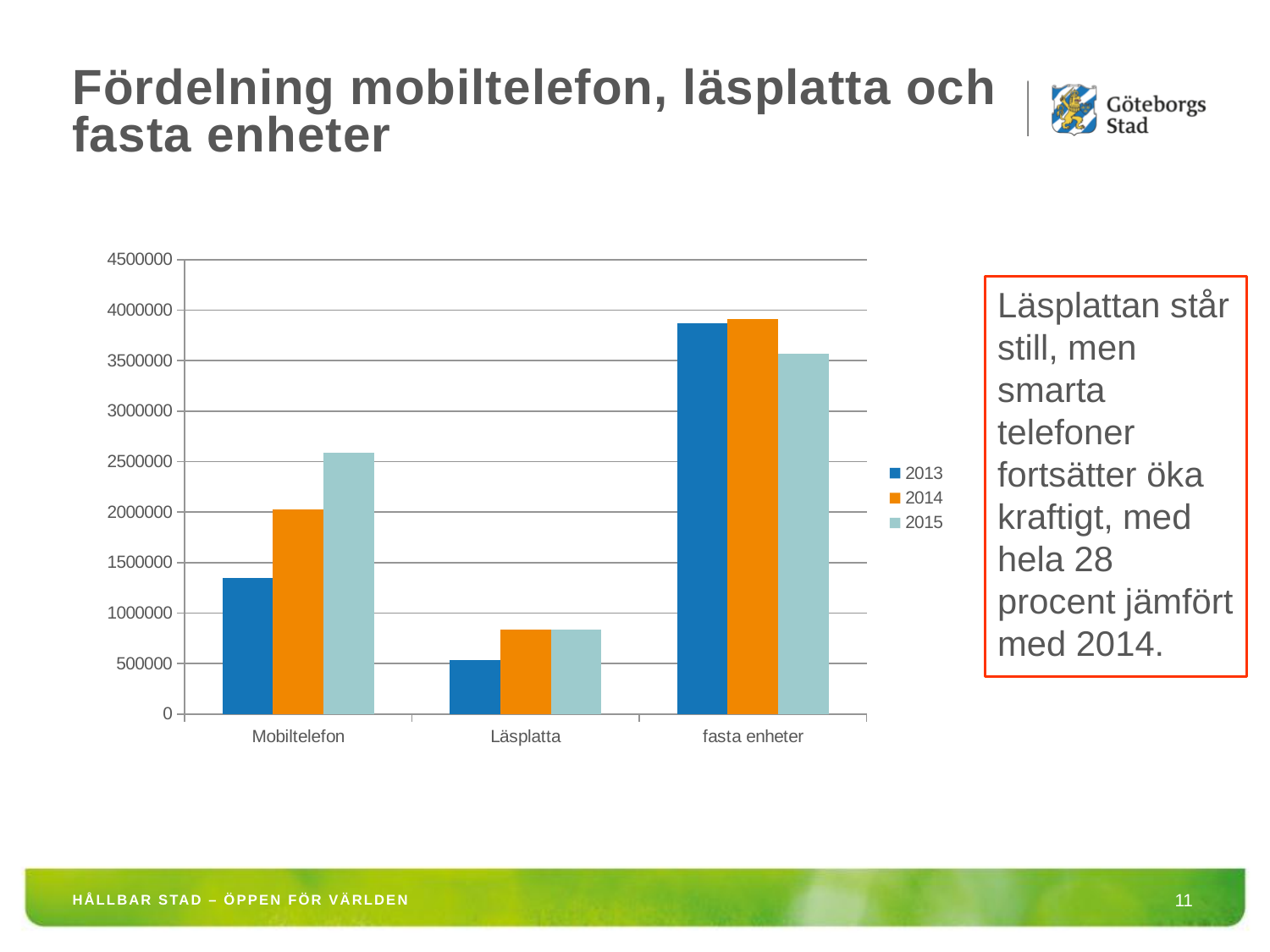
Do the values for Mobiltelefon rise or fall from 2013 to 2015? rise Is the value for Mobiltelefon in 2013 greater or less than 1500000? less Which series are listed in the chart's legend? 2013, 2014, 2015 Which is larger for fasta enheter: the 2014 value or the 2015 value? 2014 Is the value for fasta enheter in 2013 greater or less than 4000000? less How many series does the chart's legend list? 3 Is the value for Mobiltelefon in 2015 greater or less than 2000000? greater Which category has the lowest value for 2013? Läsplatta How many categories are shown on the x axis of the chart? 3 Which category has the highest value for 2015? fasta enheter What kind of chart is shown on the slide? bar chart